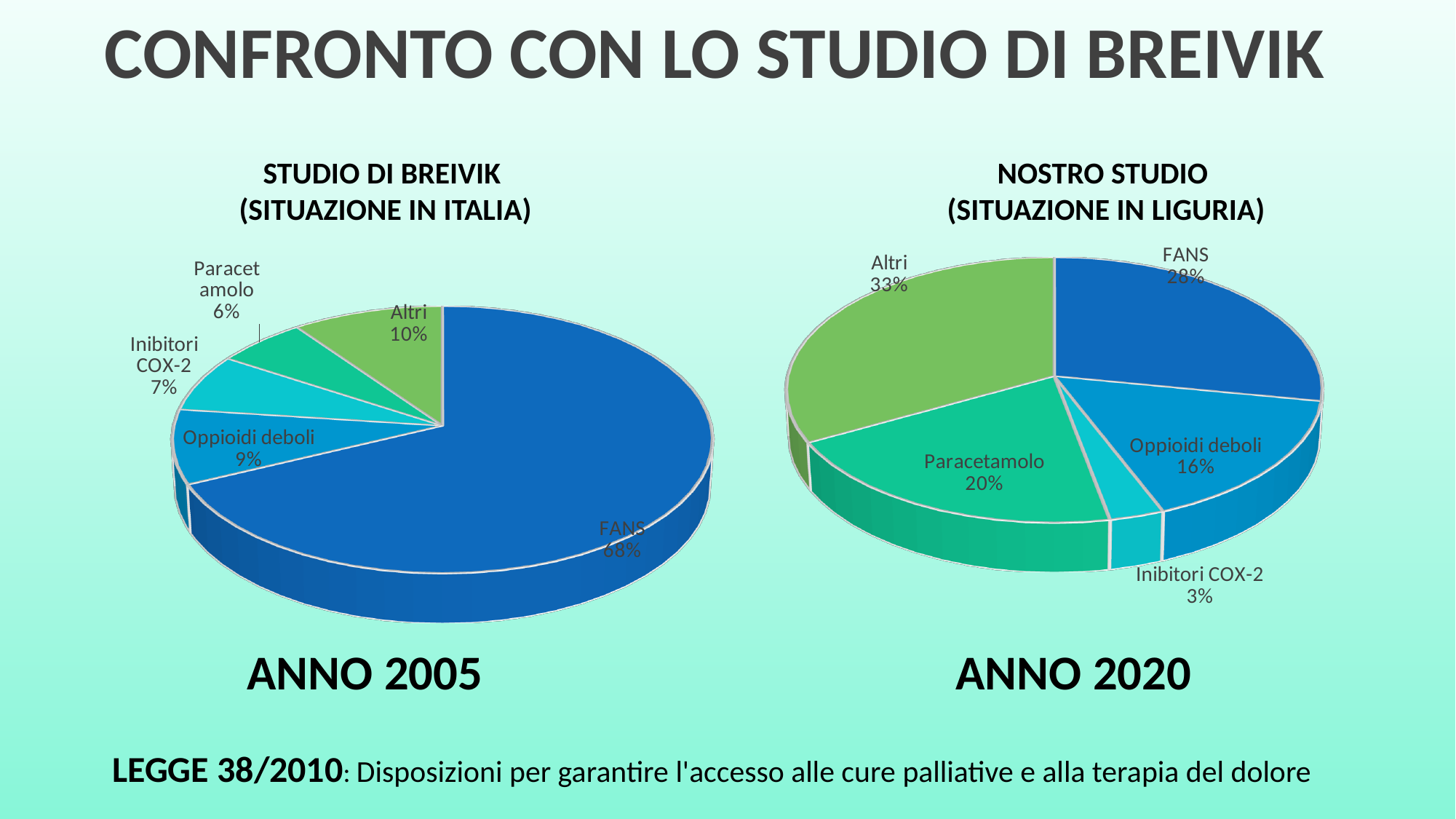
In the 'STUDIO DI BREIVIK (SITUAZIONE IN ITALIA)' chart, what is the value for Oppioidi deboli? 9% In the 'STUDIO DI BREIVIK (SITUAZIONE IN ITALIA)' chart, what share does FANS have? 68% In the 'STUDIO DI BREIVIK (SITUAZIONE IN ITALIA)' chart, which category has the smallest slice? Paracetamolo Which is larger: the FANS share in the 'STUDIO DI BREIVIK' chart or the FANS share in the 'NOSTRO STUDIO' chart? STUDIO DI BREIVIK In the 'NOSTRO STUDIO (SITUAZIONE IN LIGURIA)' chart, what is the difference between the Altri and FANS shares? 5% In the 'NOSTRO STUDIO (SITUAZIONE IN LIGURIA)' chart, what is the value for Paracetamolo? 20% In the 'STUDIO DI BREIVIK (SITUAZIONE IN ITALIA)' chart, how many slices does the pie have? 5 Which year is shown under the 'NOSTRO STUDIO (SITUAZIONE IN LIGURIA)' chart? ANNO 2020 In the 'NOSTRO STUDIO (SITUAZIONE IN LIGURIA)' chart, which category has the smallest slice? Inibitori COX-2 What type of chart is used for the 'STUDIO DI BREIVIK (SITUAZIONE IN ITALIA)' data? Pie chart In the 'NOSTRO STUDIO (SITUAZIONE IN LIGURIA)' chart, which category has the largest slice? Altri In the 'NOSTRO STUDIO (SITUAZIONE IN LIGURIA)' chart, what is the value for Inibitori COX-2? 3%